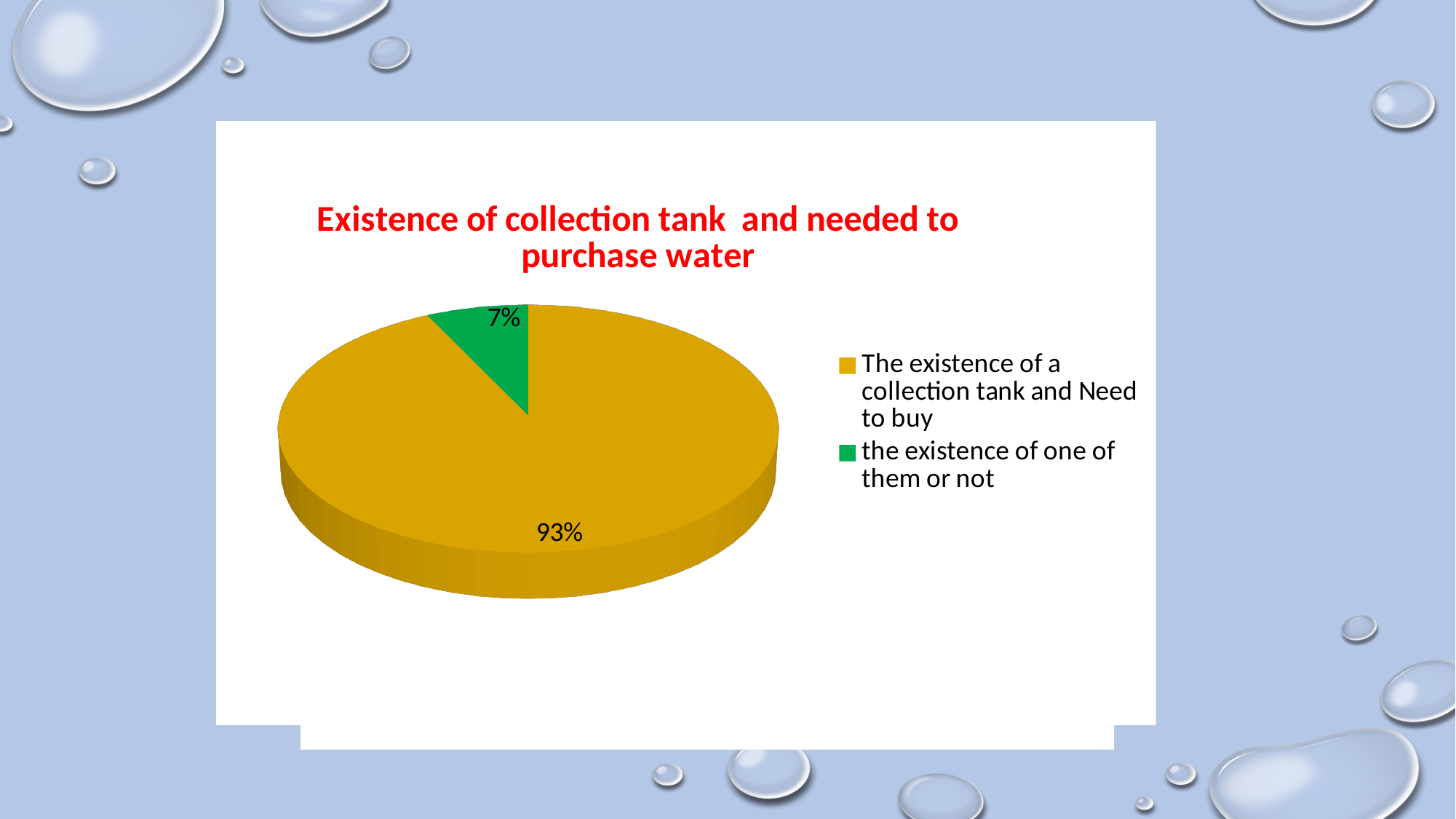
What share of the pie is labelled for 'The existence of a collection tank and Need to buy'? 93% What kind of chart is shown on the slide? pie chart Which category has the largest slice of the pie? The existence of a collection tank and Need to buy Which is larger: the slice for 'The existence of a collection tank and Need to buy' or the slice for 'the existence of one of them or not'? The existence of a collection tank and Need to buy What share of the pie is labelled for 'the existence of one of them or not'? 7% How many entries does the legend list? 2 Which category has the smallest slice of the pie? the existence of one of them or not What colour is the slice for 'the existence of one of them or not'? green How many slices does the pie chart have? 2 What is the title of the chart? Existence of collection tank and needed to purchase water What is the difference in percentage points between the 93% slice and the 7% slice? 86